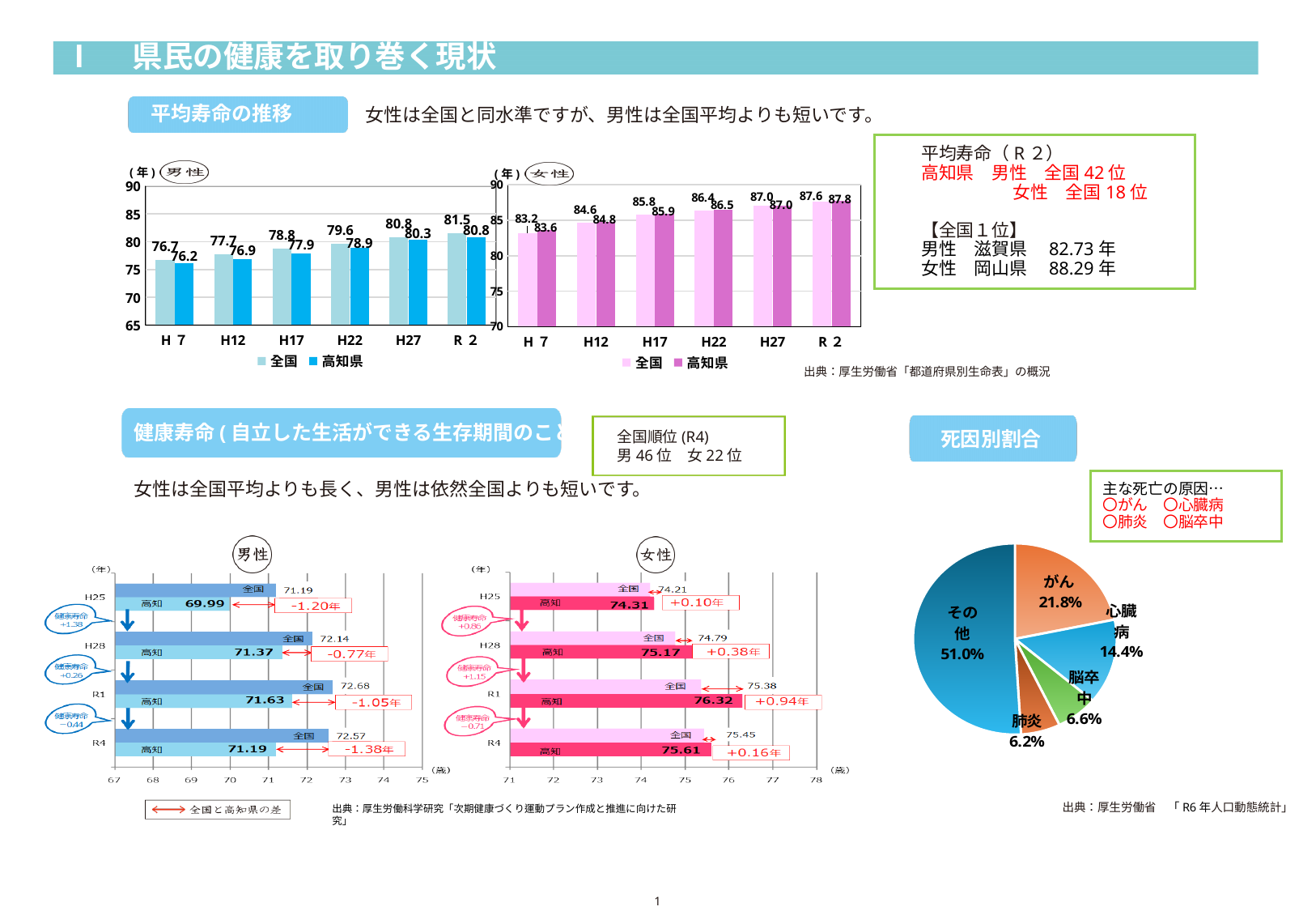
In the bottom-left male healthy life expectancy chart (男性), what is the 高知 value for R4? 71.19 In the bottom-left male healthy life expectancy chart (男性), what is the gap between 全国 and 高知 shown for H28? -0.77年 In the top-left male life expectancy bar chart (男性), do the 高知県 values rise or fall from H7 to R2? rise In the top-middle female life expectancy bar chart (女性), what is the value for 高知県 in R2? 87.8 In the pie chart 死因別割合, which slice is the smallest? 肺炎 In the top-left male life expectancy bar chart (男性), what is the difference between 全国 and 高知県 in R2? 0.7 In the top-left male life expectancy bar chart (男性), what is the value for 高知県 in R2? 80.8 In the top-middle female life expectancy bar chart (女性), which is larger in H7, 全国 or 高知県? 高知県 In the bottom-middle female healthy life expectancy chart (女性), what is the 高知 value for R1? 76.32 In the top-left male life expectancy bar chart (男性), what is the value for 全国 in H7? 76.7 In the top-middle female life expectancy bar chart (女性), how many series does the legend list? 2 In the pie chart 死因別割合, what share does がん have? 21.8%